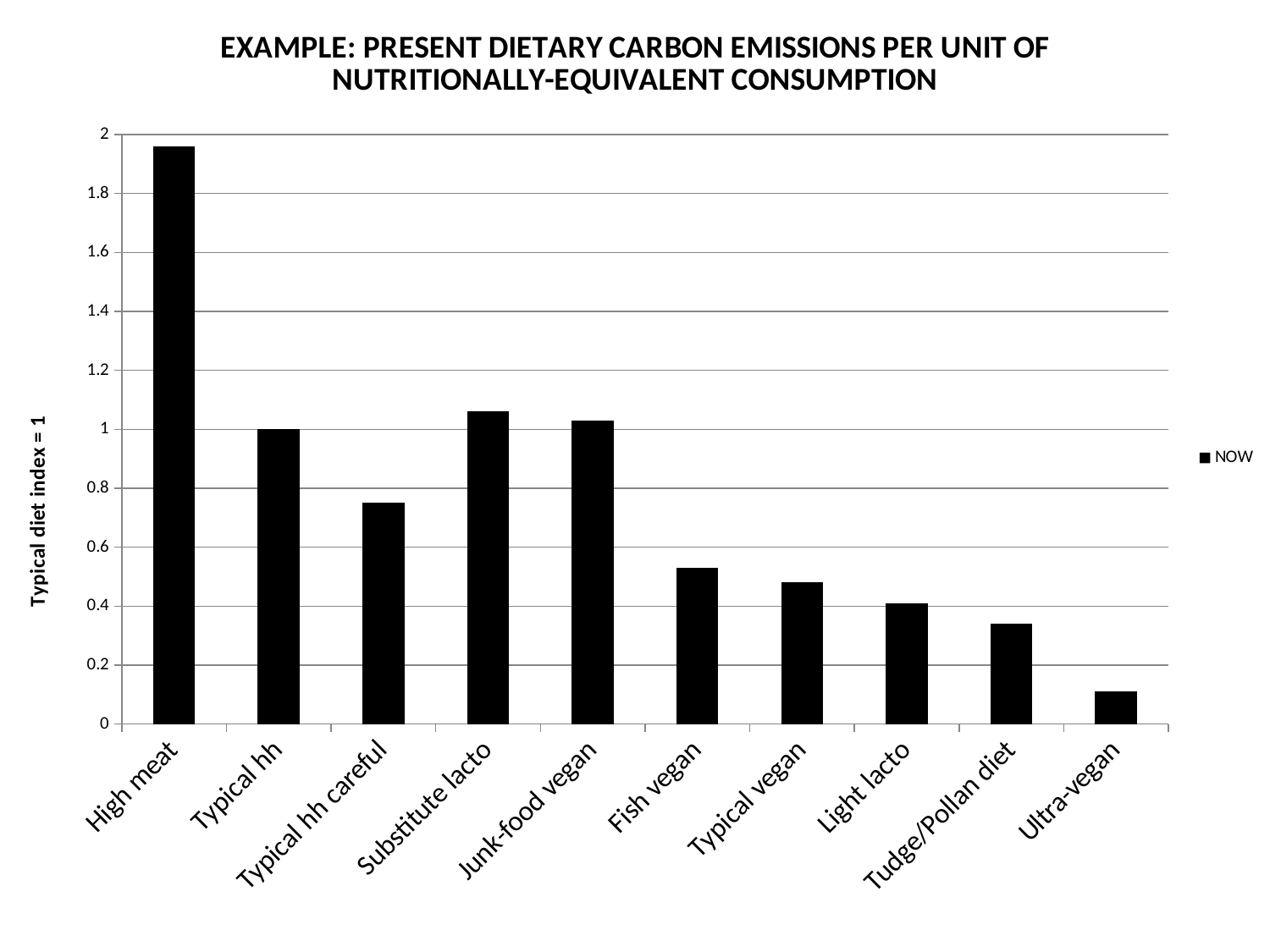
Is the value for Ultra-vegan greater or less than 0.2? less What kind of chart is shown on the slide? Bar chart Is the value for High meat greater or less than 1.8? greater Which is larger, the value for High meat or the value for Substitute lacto? High meat How many diet categories are plotted on the x axis? 10 What is the name of the series shown in the legend? NOW Which diet category has the lowest value? Ultra-vegan Which diet category has the highest value? High meat Is the value for Typical hh careful greater or less than 0.8? less What is the value for Typical hh? 1 Which is larger, the value for Light lacto or the value for Typical hh careful? Typical hh careful How many series does the legend list? 1